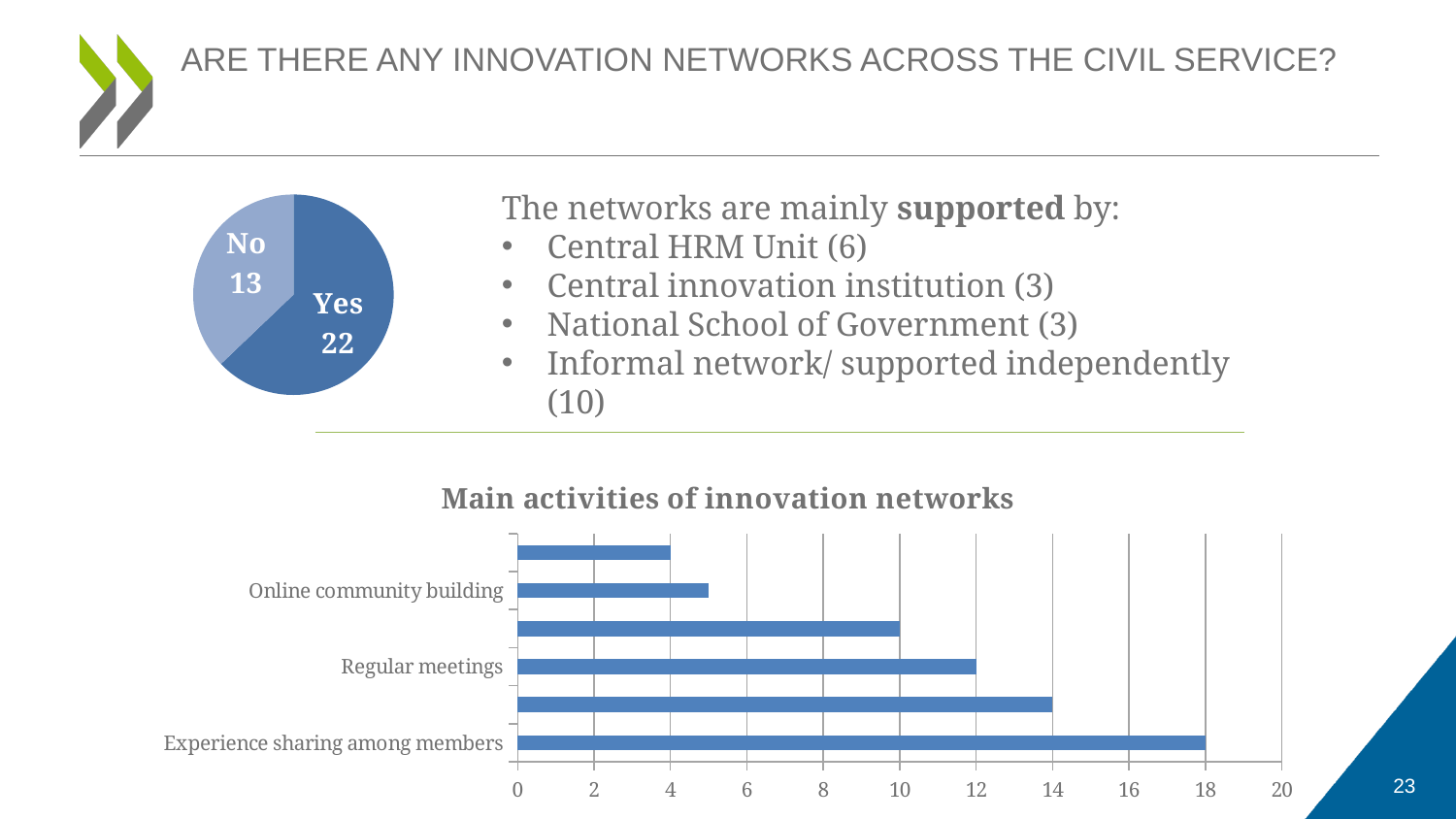
In the pie chart, what is the total of the 'Yes' and 'No' counts? 35 In the pie chart, which slice is larger, 'Yes' or 'No'? Yes In the pie chart, what is the difference between the 'Yes' and 'No' counts? 9 What kind of chart is the 'Main activities of innovation networks' chart? bar chart In the 'Main activities of innovation networks' chart, is the value for 'Online community building' greater or less than 6? less In the 'Main activities of innovation networks' chart, what is the difference between 'Experience sharing among members' and 'Regular meetings'? 6 In the 'Main activities of innovation networks' chart, what is the value for 'Experience sharing among members'? 18 In the pie chart, how many responses are 'No'? 13 In the pie chart, how many responses are 'Yes'? 22 In the 'Main activities of innovation networks' chart, what is the value for 'Regular meetings'? 12 In the 'Main activities of innovation networks' chart, how many bars are plotted? 6 In the 'Main activities of innovation networks' chart, which activity has the highest value? Experience sharing among members